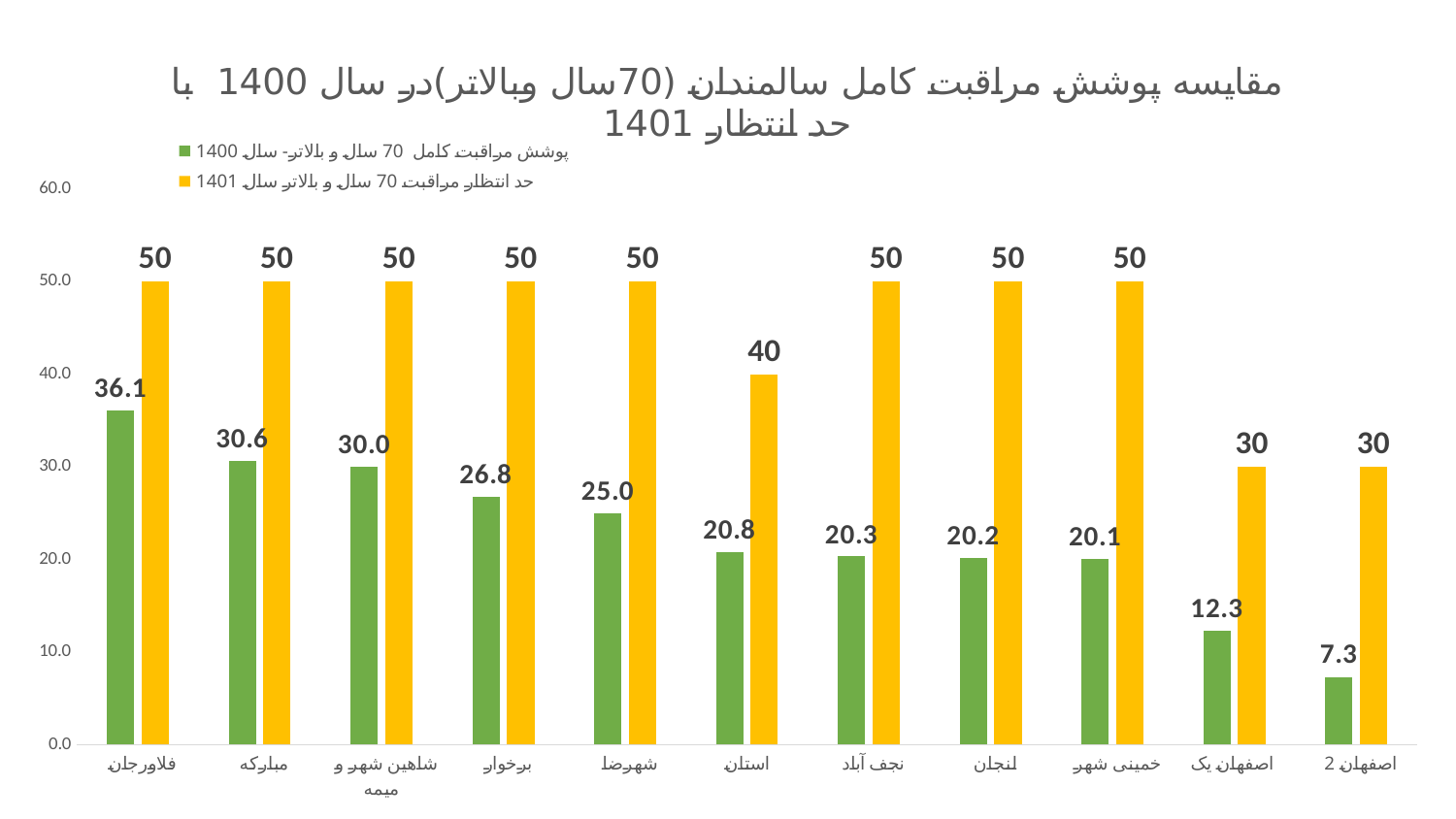
How many series does the legend list? 2 How many categories are shown along the x axis? 11 Which colour represents the 1401 expected value series in the legend? yellow Which category has the lowest 1400 coverage value (green bar)? اصفهان 2 What type of chart is shown on the slide? bar chart What is the 1400 coverage value (green bar) for اصفهان 2? 7.3 What is the 1401 expected value (yellow bar) for اصفهان یک? 30 Which category has the highest 1400 coverage value (green bar)? فلاورجان What is the 1400 coverage value (green bar) for فلاورجان? 36.1 Which is larger for مبارکه: the 1400 coverage value or the 1401 expected value? the 1401 expected value What is the difference between the 1401 expected value and the 1400 coverage value for برخوار? 23.2 What is the 1401 expected value (yellow bar) for استان? 40